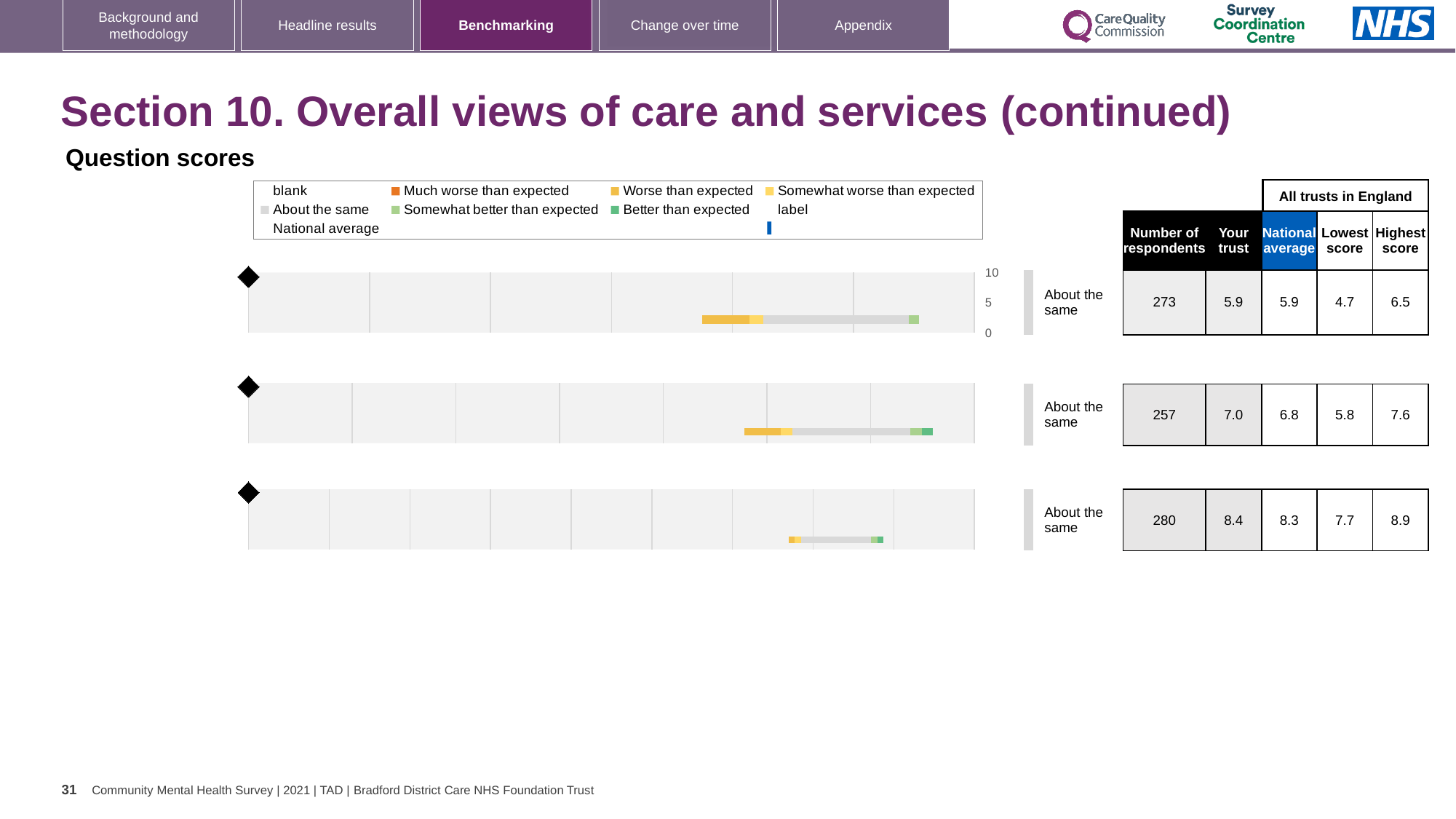
Which of the three charts has the highest 'Your trust' score? the bottom chart For the middle chart, what is the difference between the highest score and the lowest score? 1.8 For the top chart, what is the number of respondents shown in the table? 273 What kind of chart is used for the three question score displays on the slide? bar chart For the bottom chart, what is the number of respondents? 280 For the bottom chart, what is the highest score among all trusts in England? 8.9 For the bottom chart, what is the difference between the highest score and the lowest score? 1.2 How many question score charts are shown on the slide? 3 For the middle chart, which is larger: the 'Your trust' score or the national average? Your trust For the middle chart, what is the national average score? 6.8 For the top chart, what is the 'Your trust' score? 5.9 What benchmark category label is shown next to each of the three charts? About the same